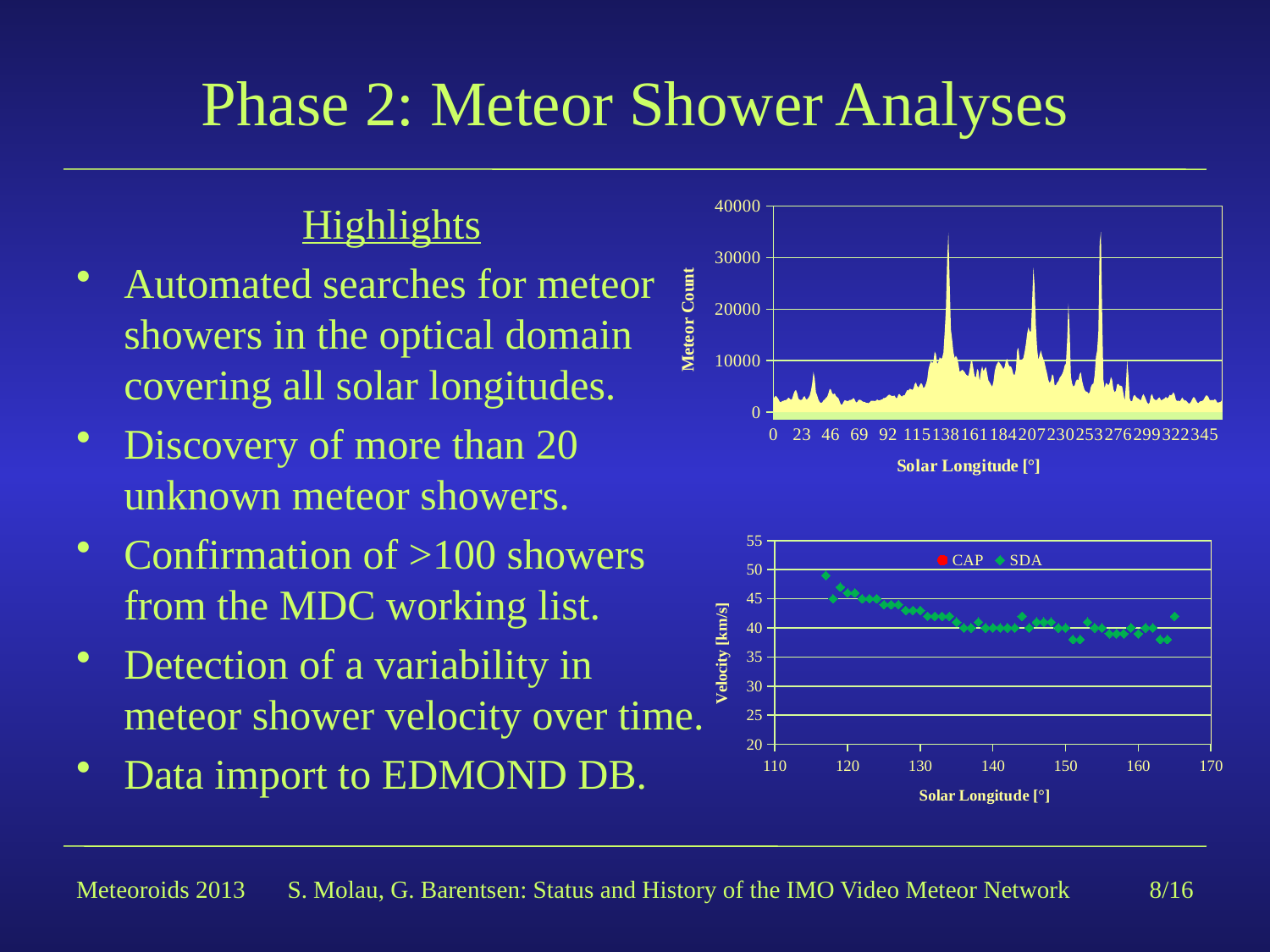
In the bottom chart, do the velocity values generally rise or fall as solar longitude increases from 110 to 170? fall In the bottom chart, is the velocity of the first plotted point (near solar longitude 117) greater or less than 45 km/s? greater In the bottom chart, how many series does the legend list? 2 In the bottom chart, what is the maximum value shown on the vertical axis? 55 What is the label of the vertical axis of the top chart? Meteor Count What kind of chart is the top chart? area chart In the top chart, is the highest peak of the meteor count greater or less than 30000? greater In the bottom chart, what are the names of the series in the legend? CAP and SDA In the bottom chart, is the velocity of the points near solar longitude 160 greater or less than 45 km/s? less What kind of chart is the bottom chart? scatter chart In the top chart, what is the maximum value shown on the vertical axis? 40000